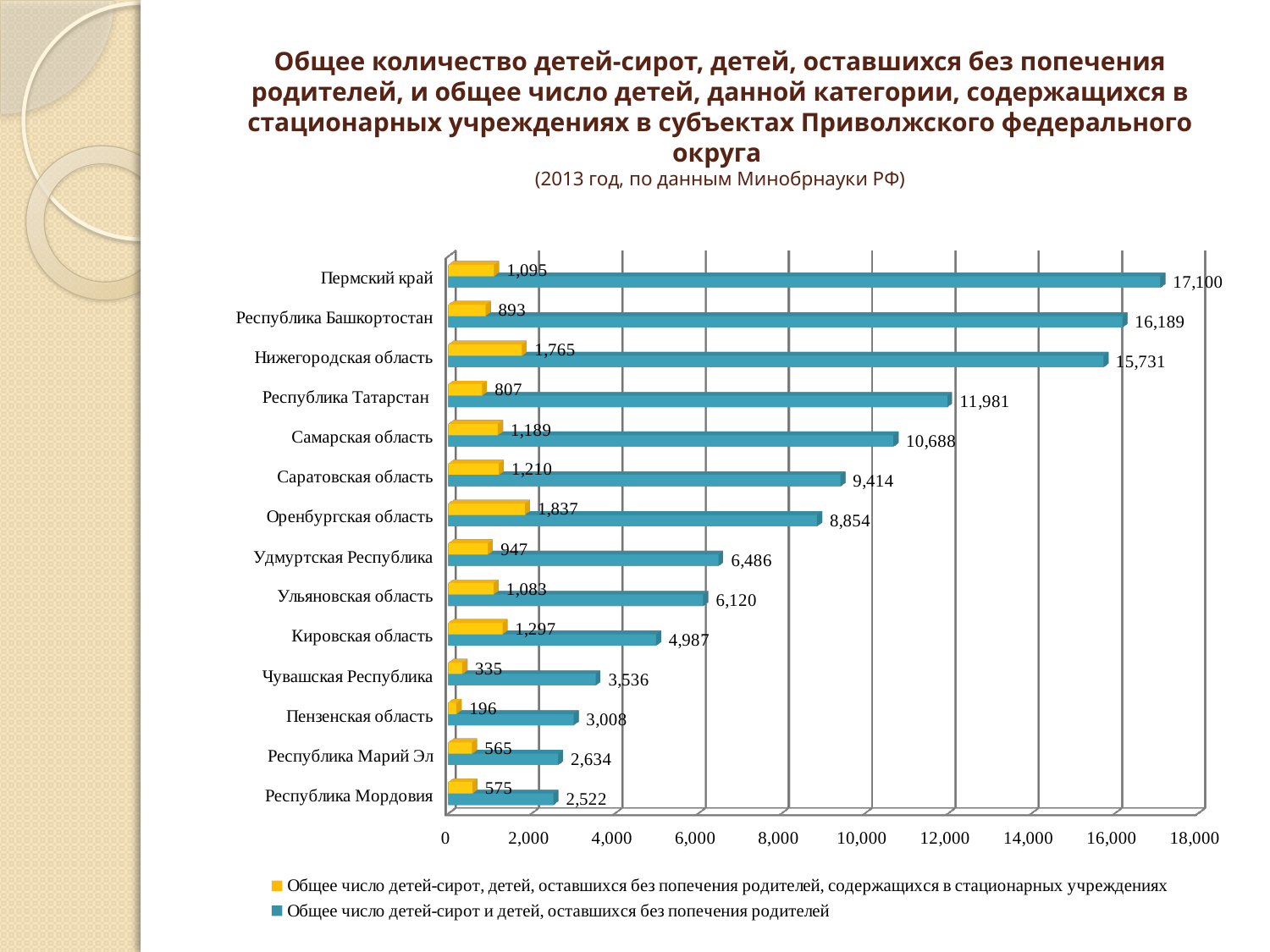
How many series does the legend list? 2 What is the total number of orphans and children left without parental care (blue series) for Республика Мордовия? 2,522 What is the number of children in stationary institutions (yellow series) for Оренбургская область? 1,837 What year does the chart's subtitle say the data is for? 2013 What is the total number of orphans and children left without parental care (blue series) for Пермский край? 17,100 Which region has the lowest number of children in stationary institutions (yellow series)? Пензенская область What is the difference between the blue-series values for Республика Башкортостан and Нижегородская область? 458 How many regions are shown on the chart? 14 Is the blue-series value for Республика Татарстан greater or less than 12,000? less Which region has a larger yellow-series value: Самарская область or Саратовская область? Саратовская область Which region has the highest total number of orphans and children left without parental care (blue series)? Пермский край What type of chart is shown on the slide? bar chart